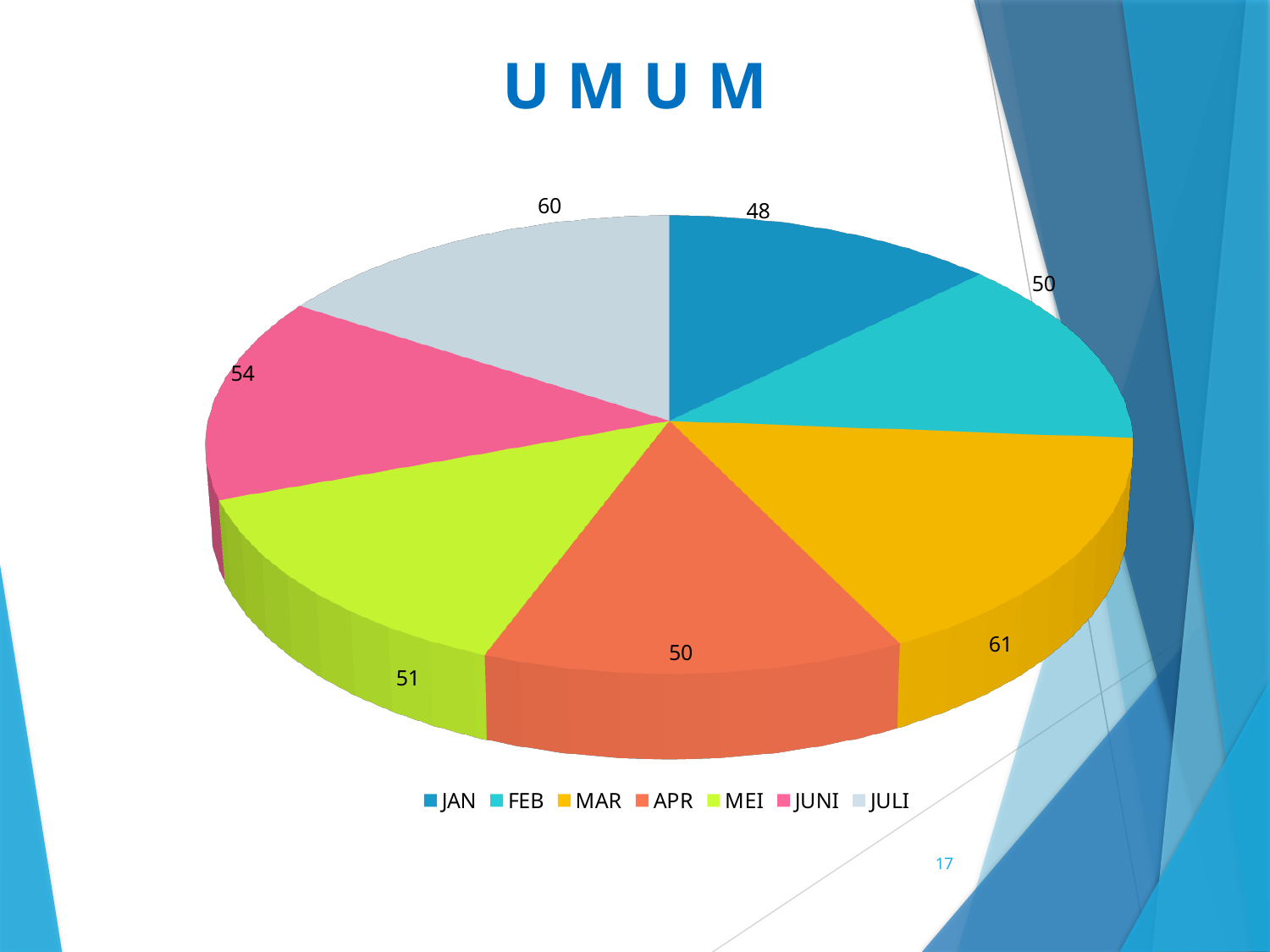
What is the value for JUNI in the pie chart? 54 What is the title of the chart on the slide? UMUM Which is larger, the value for JUNI or the value for MEI? JUNI Which category has the highest value in the pie chart? MAR What is the total of all the values shown in the pie chart? 374 What is the value for JULI in the pie chart? 60 What is the value for MAR in the pie chart? 61 What is the difference between the values for MAR and JAN? 13 How many slices does the pie chart have? 7 What kind of chart is shown on the slide? pie chart Which category has the lowest value in the pie chart? JAN What is the value for JAN in the pie chart? 48